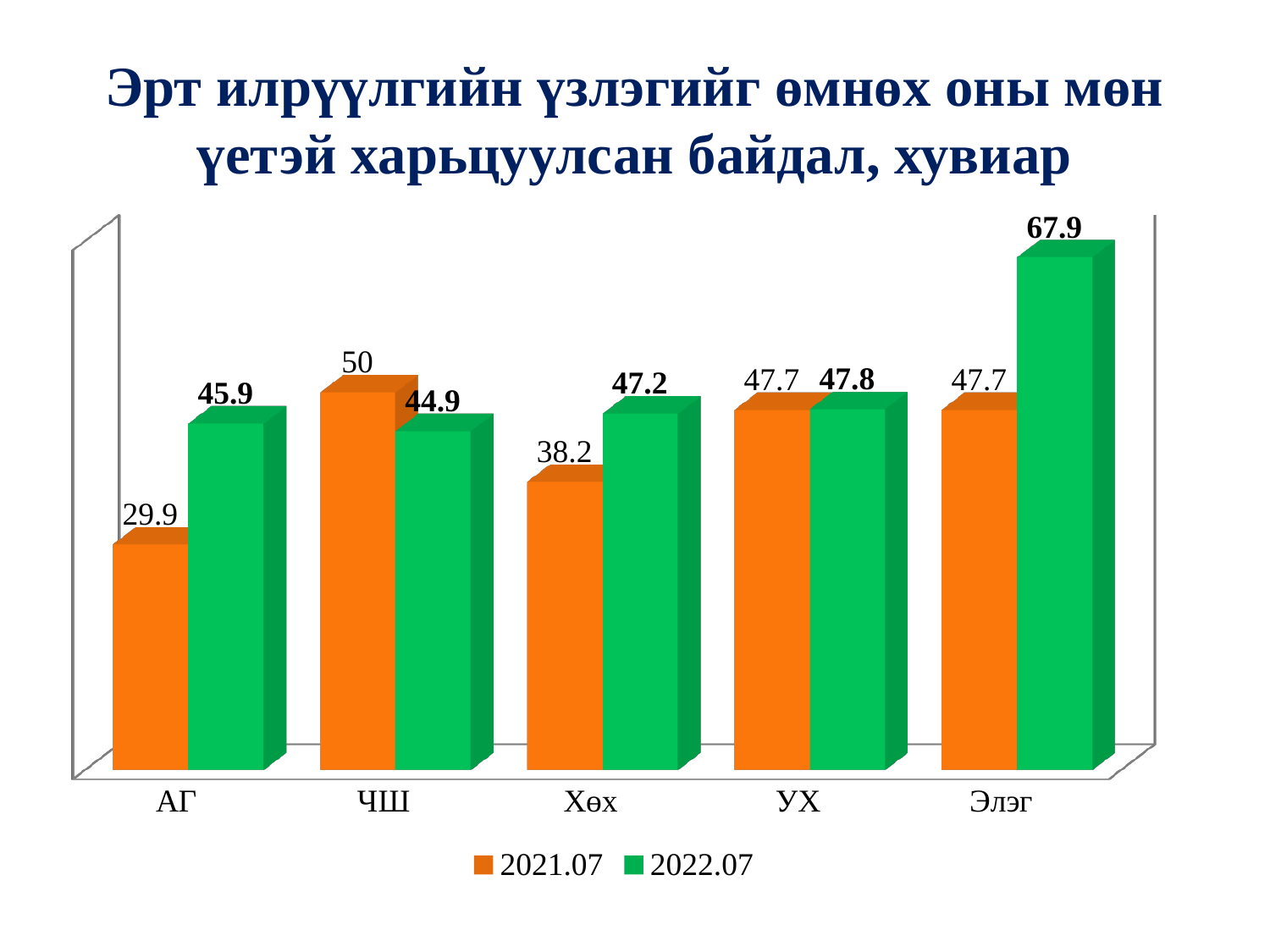
Which series is shown in green in the legend? 2022.07 What is the value for ЧШ in the 2021.07 series? 50 What is the value for АГ in the 2022.07 series? 45.9 How many categories are shown on the x axis? 5 What kind of chart is shown on the slide? Bar chart What is the difference between the 2022.07 and 2021.07 values for Элэг? 20.2 Which category has the highest value in the 2022.07 series? Элэг What is the value for Хөх in the 2021.07 series? 38.2 Which is larger for ЧШ: the 2021.07 value or the 2022.07 value? 2021.07 What is the value for Элэг in the 2022.07 series? 67.9 Which category has the lowest value in the 2021.07 series? АГ How many series does the legend list? 2